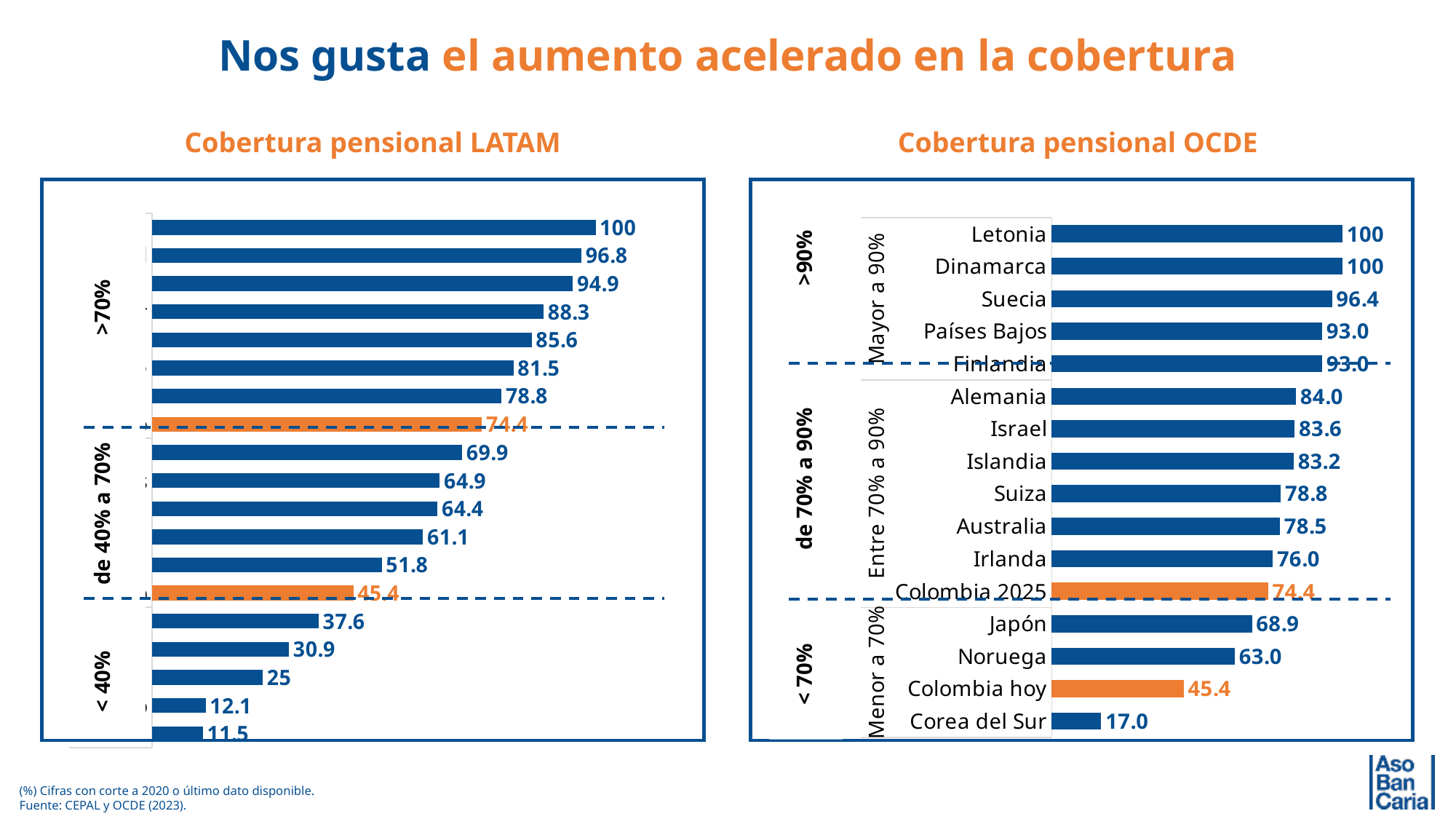
In the 'Cobertura pensional OCDE' chart, which two countries share the highest value of 100? Letonia and Dinamarca What kind of chart is the 'Cobertura pensional OCDE' chart? Bar chart In the 'Cobertura pensional OCDE' chart, how many bars are plotted? 16 In the 'Cobertura pensional LATAM' chart, how many bars are plotted? 19 In the 'Cobertura pensional OCDE' chart, which is larger, Japón or Noruega? Japón In the 'Cobertura pensional OCDE' chart, which country has the lowest value? Corea del Sur In the 'Cobertura pensional OCDE' chart, what is the value for Suecia? 96.4 In the 'Cobertura pensional OCDE' chart, what is the value for Colombia hoy? 45.4 In the 'Cobertura pensional OCDE' chart, which bars are coloured orange? Colombia 2025 and Colombia hoy In the 'Cobertura pensional OCDE' chart, what is the difference between Colombia 2025 and Colombia hoy? 29.0 In the 'Cobertura pensional LATAM' chart, what is the lowest value shown? 11.5 In the 'Cobertura pensional OCDE' chart, what is the value for Irlanda? 76.0